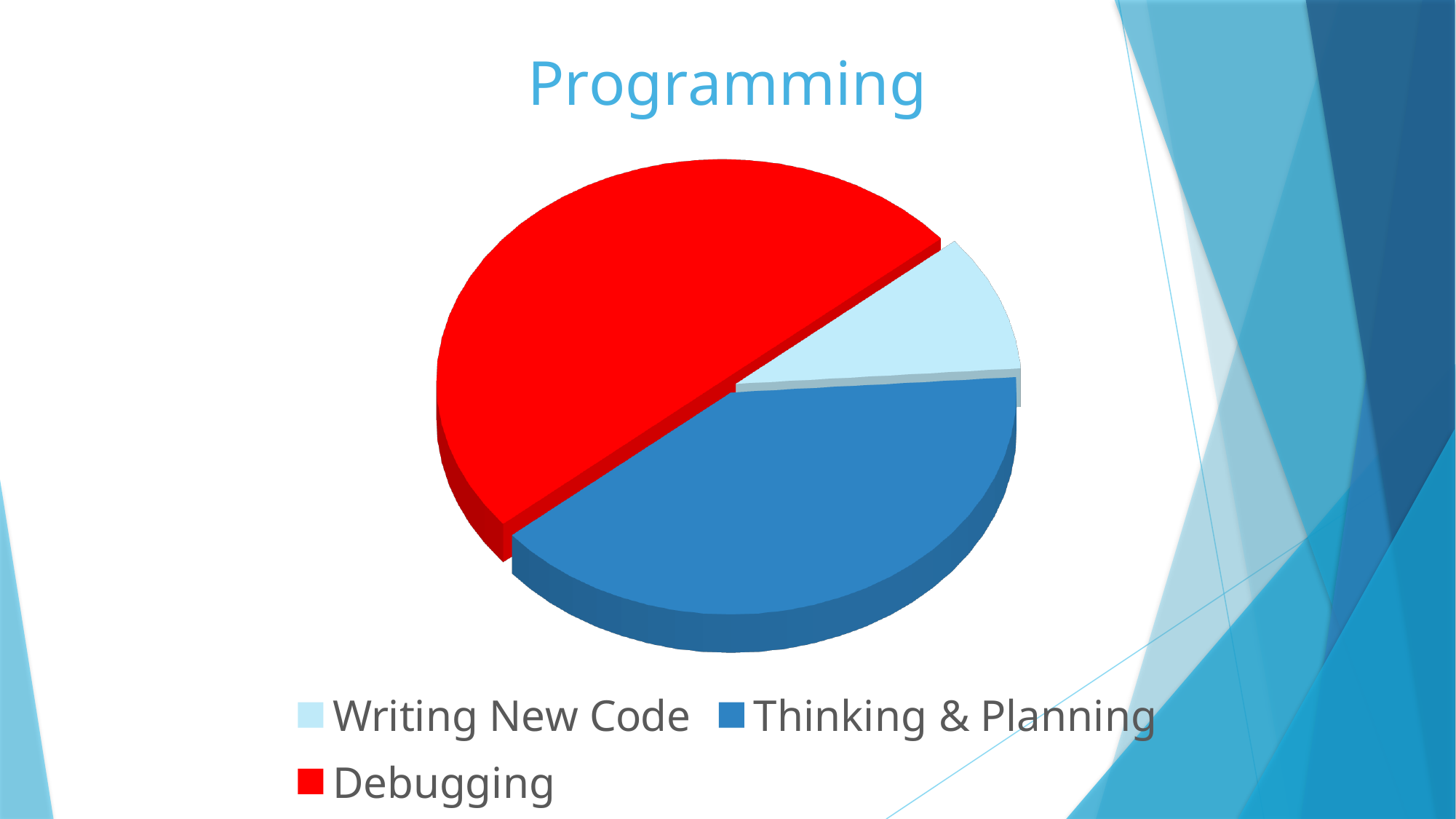
Which slice is larger, Debugging or Thinking & Planning? Debugging Which slice is larger, Thinking & Planning or Writing New Code? Thinking & Planning What kind of chart is shown on the slide? Pie chart Which category has the smallest slice of the pie? Writing New Code How many entries does the legend list? 3 What is the title of the chart? Programming Which slice is smaller, Writing New Code or Debugging? Writing New Code How many slices does the pie chart have? 3 What colour is the Debugging slice? Red Which category has the largest slice of the pie? Debugging